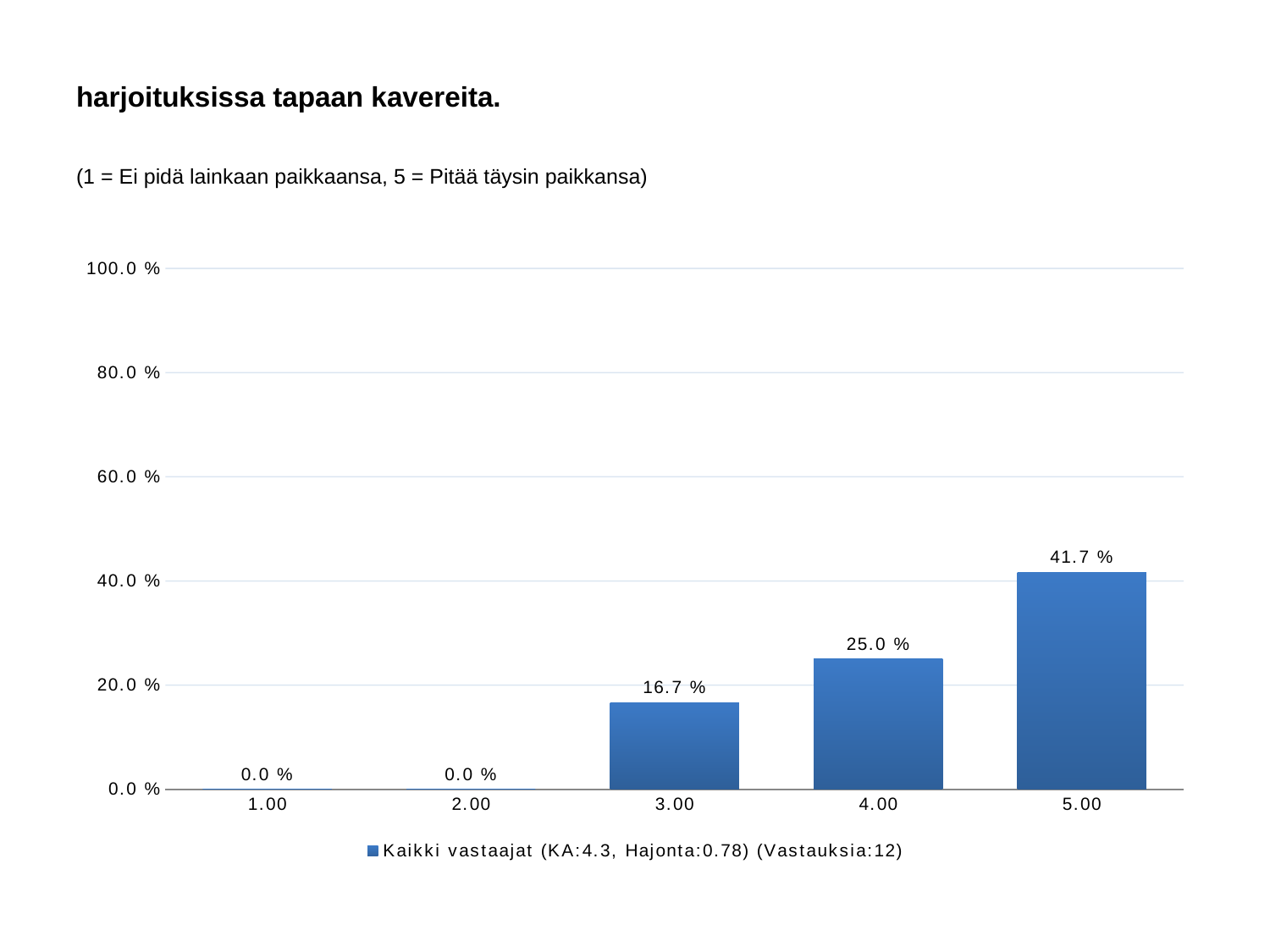
What is the value for category 1.00? 0.0 % Which category has the highest value? 5.00 What is the value for category 4.00? 25.0 % What is the difference between the values for 4.00 and 3.00? 8.3 % Is the value for 5.00 greater or less than 40.0 %? greater What is the difference between the values for 5.00 and 4.00? 16.7 % What is the value for category 3.00? 16.7 % What is the value for category 5.00? 41.7 % Which is larger, the value for 3.00 or the value for 4.00? 4.00 Do the values rise or fall from category 1.00 to category 5.00? rise What kind of chart is shown on the slide? bar chart How many categories are shown on the x axis? 5